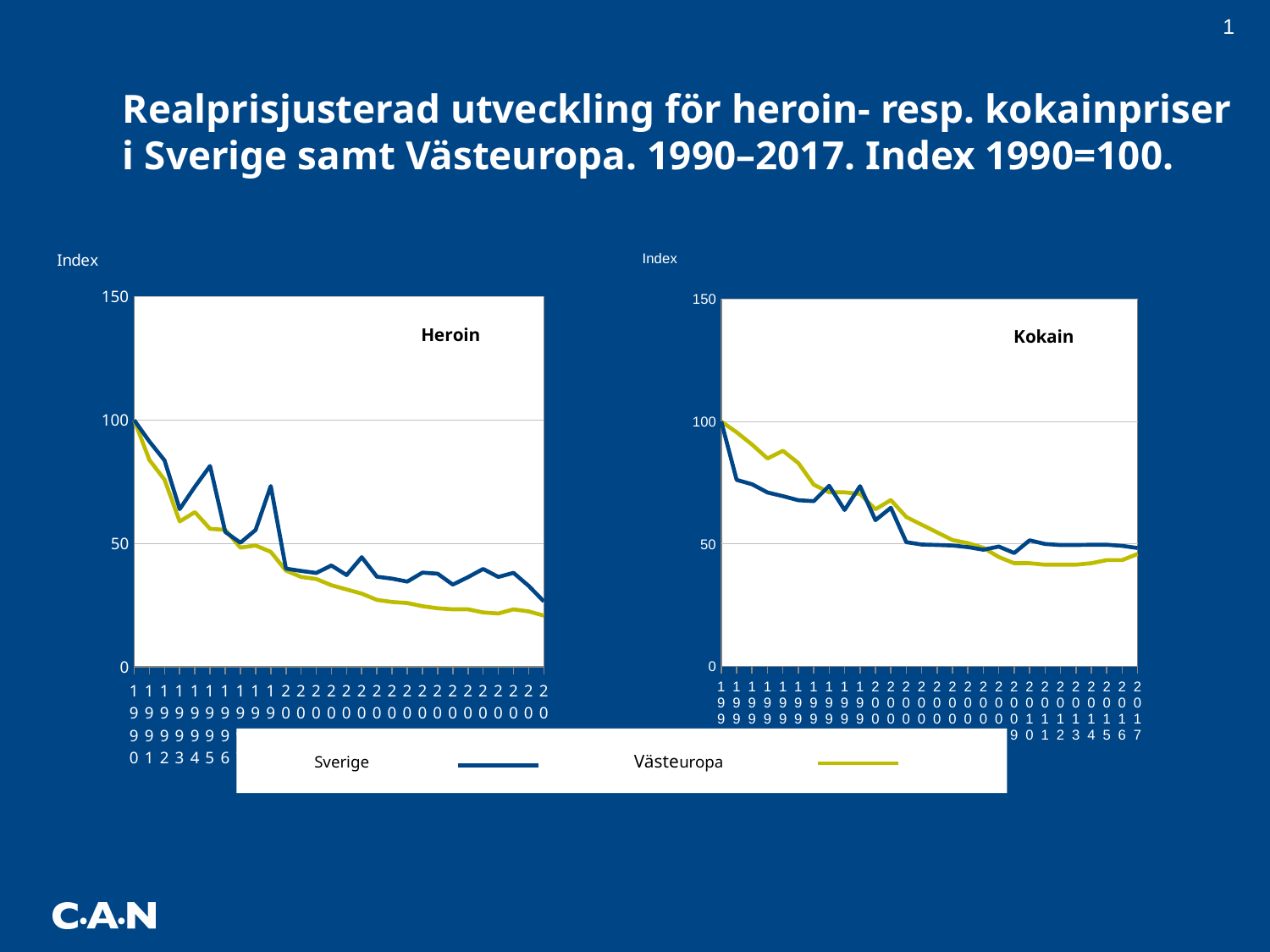
In the Kokain chart, what is the index value for Västeuropa in 1990? 100 In the Heroin chart, in which year is the Sverige value highest? 1990 In the Heroin chart, what is the index value for Sverige in 1990? 100 In the Kokain chart, do the Västeuropa values generally rise or fall from 1990 to 2017? fall What kind of chart is the Heroin chart? line chart In the Heroin chart, which series has the higher value in 2017, Sverige or Västeuropa? Sverige In the Heroin chart, do the Sverige values generally rise or fall from 1990 to 2017? fall How many series does the legend list? 2 In the Heroin chart, is the value for Sverige in 2017 greater or less than 50? less What colour is the line for Sverige in the legend? blue In the Kokain chart, which series has the higher value in 1991, Sverige or Västeuropa? Västeuropa In the Kokain chart, is the value for Västeuropa in 1991 greater or less than 50? greater